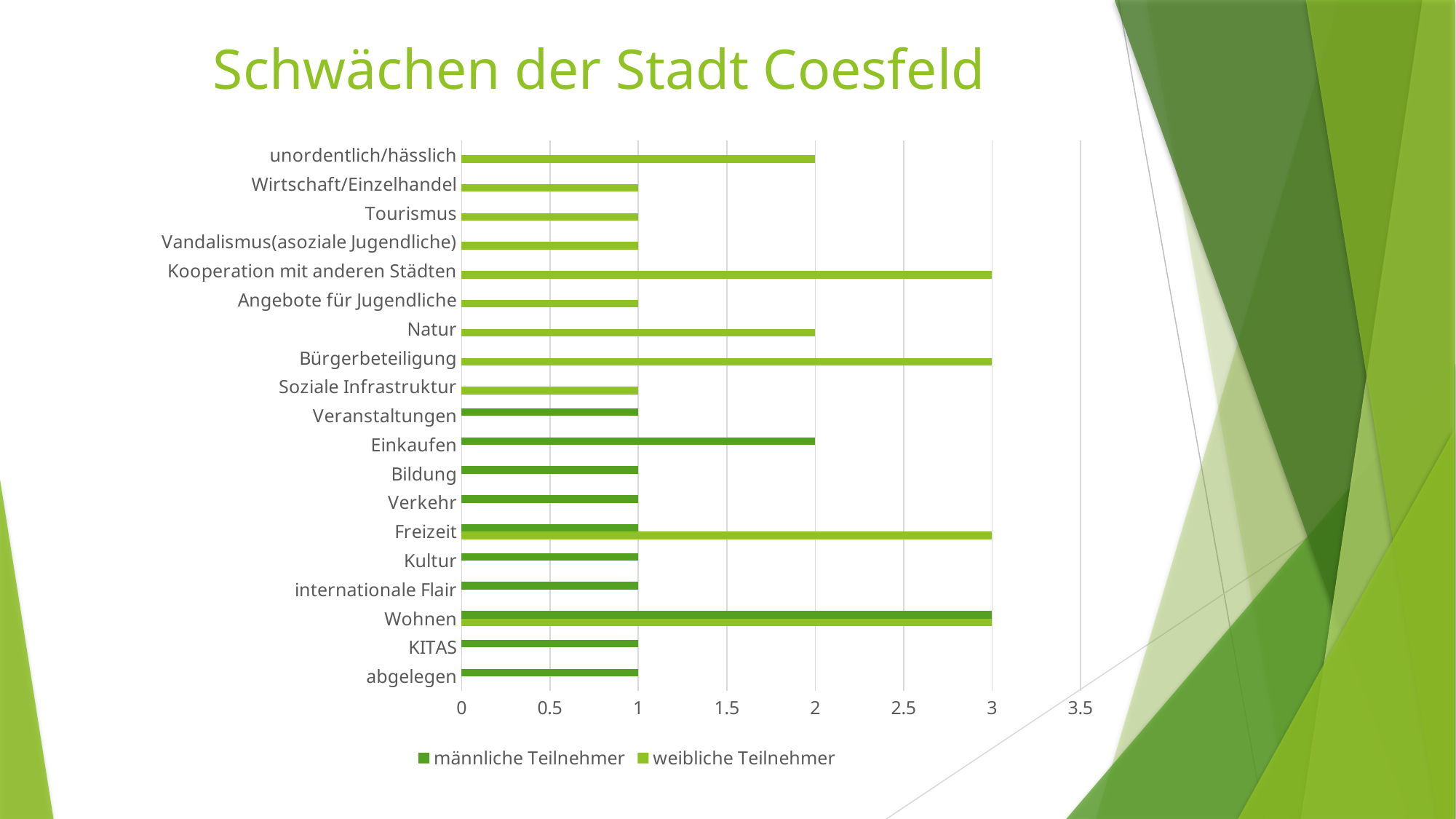
Is the value for weibliche Teilnehmer for unordentlich/hässlich greater or less than 1.5? greater What is the difference between the weibliche Teilnehmer and männliche Teilnehmer values for Freizeit? 2 What is the title of the chart slide? Schwächen der Stadt Coesfeld What is the value for weibliche Teilnehmer for Kooperation mit anderen Städten? 3 How many categories are shown on the vertical axis? 19 Which is larger for Freizeit: the männliche Teilnehmer value or the weibliche Teilnehmer value? weibliche Teilnehmer What is the value for männliche Teilnehmer for Einkaufen? 2 Which is larger: the weibliche Teilnehmer value for Natur or for Bürgerbeteiligung? Bürgerbeteiligung What kind of chart is shown on the slide? bar chart What is the value for weibliche Teilnehmer for Freizeit? 3 How many series does the legend list? 2 What is the value for männliche Teilnehmer for Wohnen? 3